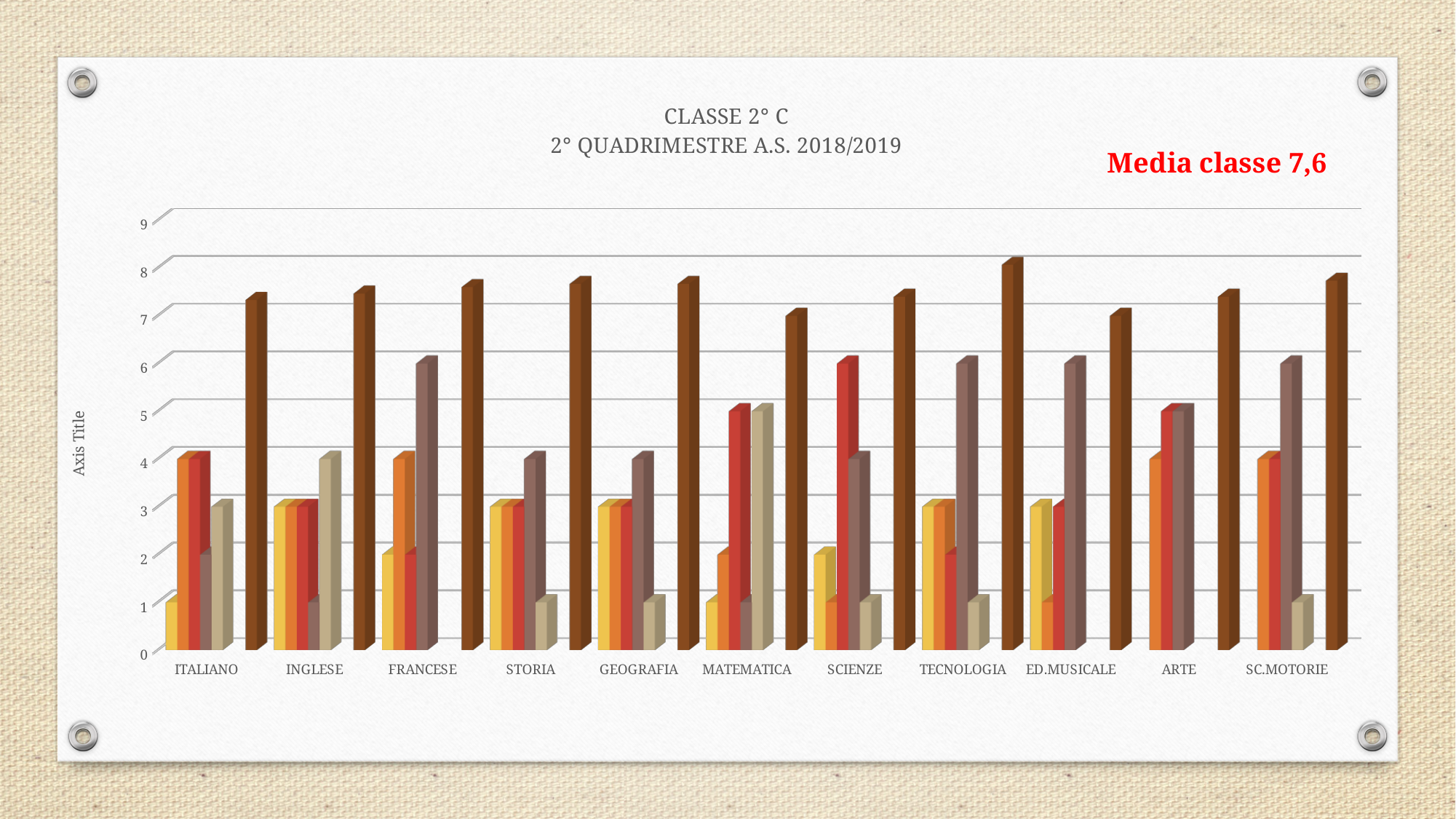
Which subject has the tallest bar in the chart? TECNOLOGIA How many subject categories are shown on the x axis? 11 Is the tallest bar for TECNOLOGIA greater or less than 7? greater What kind of chart is shown on the slide? Bar chart Is the shortest bar for ITALIANO greater or less than 2? less Is the tallest bar for MATEMATICA greater or less than 8? less What is the highest value shown on the vertical axis? 9 Which has the taller tallest bar, TECNOLOGIA or MATEMATICA? TECNOLOGIA What is the title of the chart? CLASSE 2° C 2° QUADRIMESTRE A.S. 2018/2019